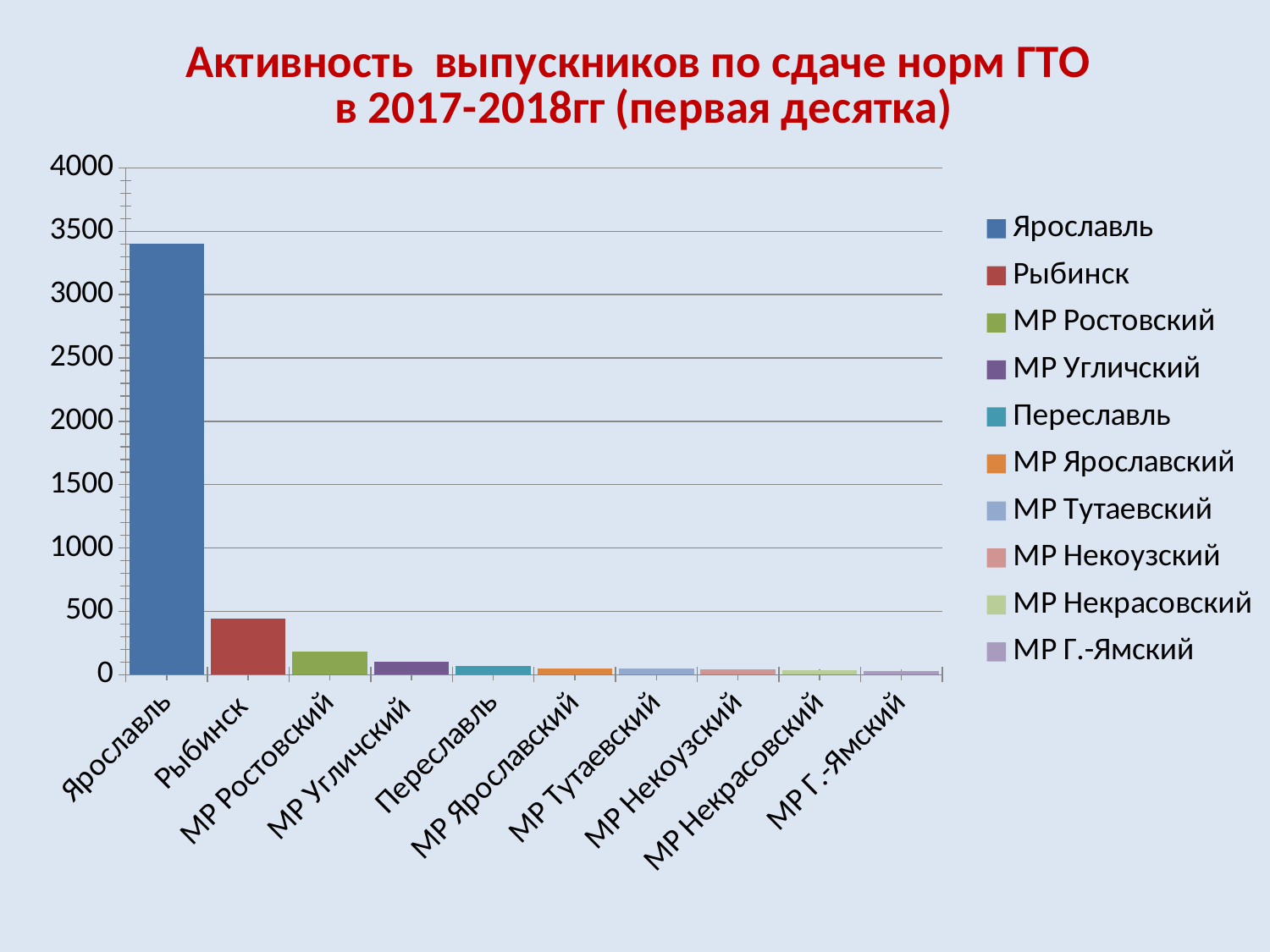
How many entries does the legend list? 10 Which category has the highest value? Ярославль Is the value for Ярославль greater or less than 3000? greater Do the values rise or fall moving from left to right along the x axis? fall Which is larger, the value for Рыбинск or the value for МР Ростовский? Рыбинск Is the value for МР Ростовский greater or less than 500? less Is the value for Ярославль greater or less than 3500? less What is the title of the chart? Активность выпускников по сдаче норм ГТО в 2017-2018гг (первая десятка) Which is larger, the value for Ярославль or the value for Рыбинск? Ярославль How many categories are plotted along the x axis? 10 What kind of chart is shown on the slide? bar chart